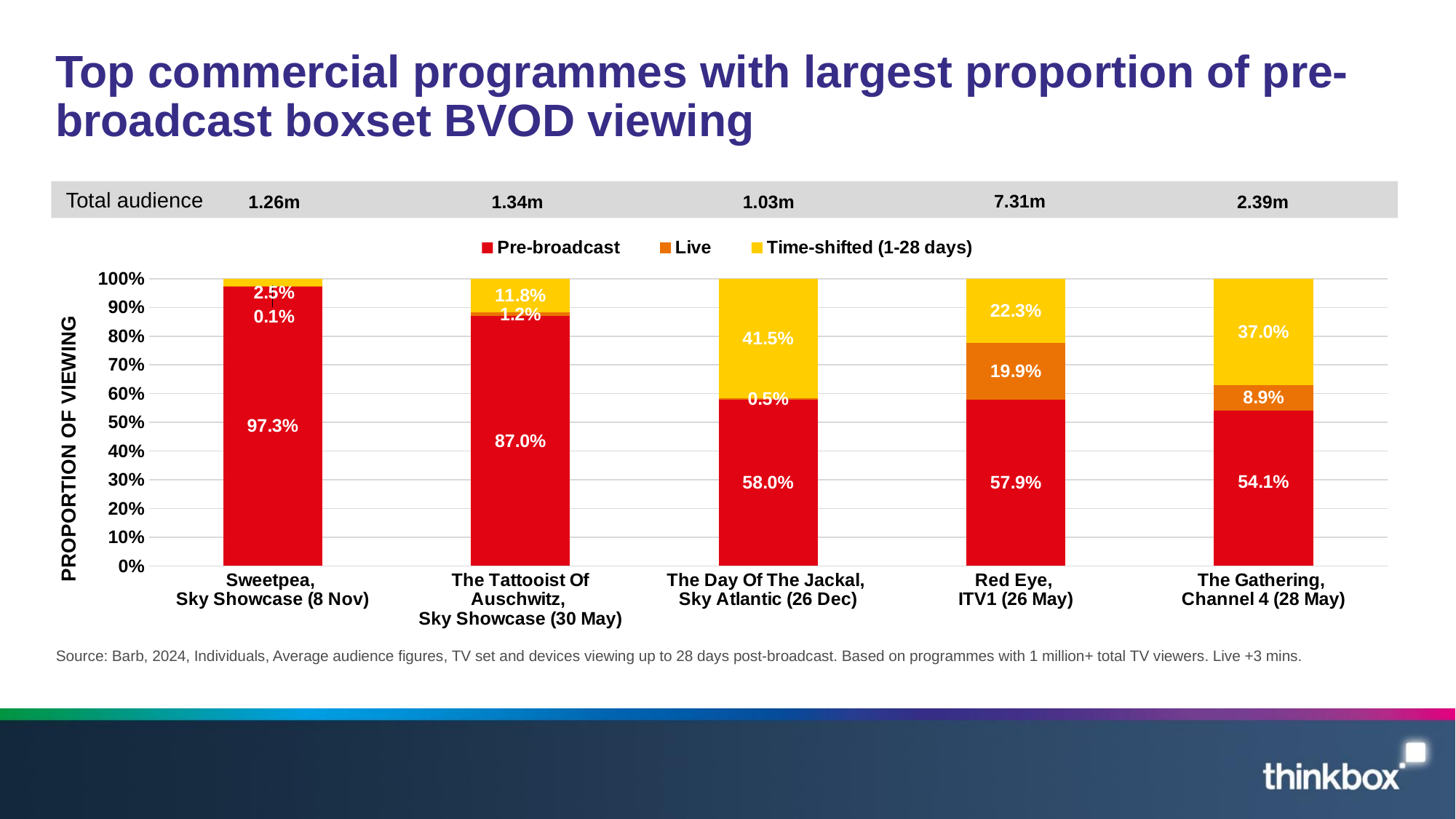
Which programme has the highest Live proportion of viewing? Red Eye, ITV1 (26 May) What is the Pre-broadcast proportion of viewing for Sweetpea, Sky Showcase (8 Nov)? 97.3% What kind of chart is shown on the slide? Stacked bar chart Which programme has the highest Pre-broadcast proportion of viewing? Sweetpea, Sky Showcase (8 Nov) What is the difference in Pre-broadcast proportion between Sweetpea and The Tattooist Of Auschwitz? 10.3 percentage points What is the Time-shifted (1-28 days) proportion for The Day Of The Jackal, Sky Atlantic (26 Dec)? 41.5% How many series does the legend list? 3 What is the Pre-broadcast proportion for The Gathering, Channel 4 (28 May)? 54.1% Which programme has the lowest Pre-broadcast proportion of viewing? The Gathering, Channel 4 (28 May) What is the Live proportion of viewing for Red Eye, ITV1 (26 May)? 19.9% Which has a larger Time-shifted (1-28 days) proportion: The Day Of The Jackal or The Gathering? The Day Of The Jackal How many programmes are shown on the chart? 5